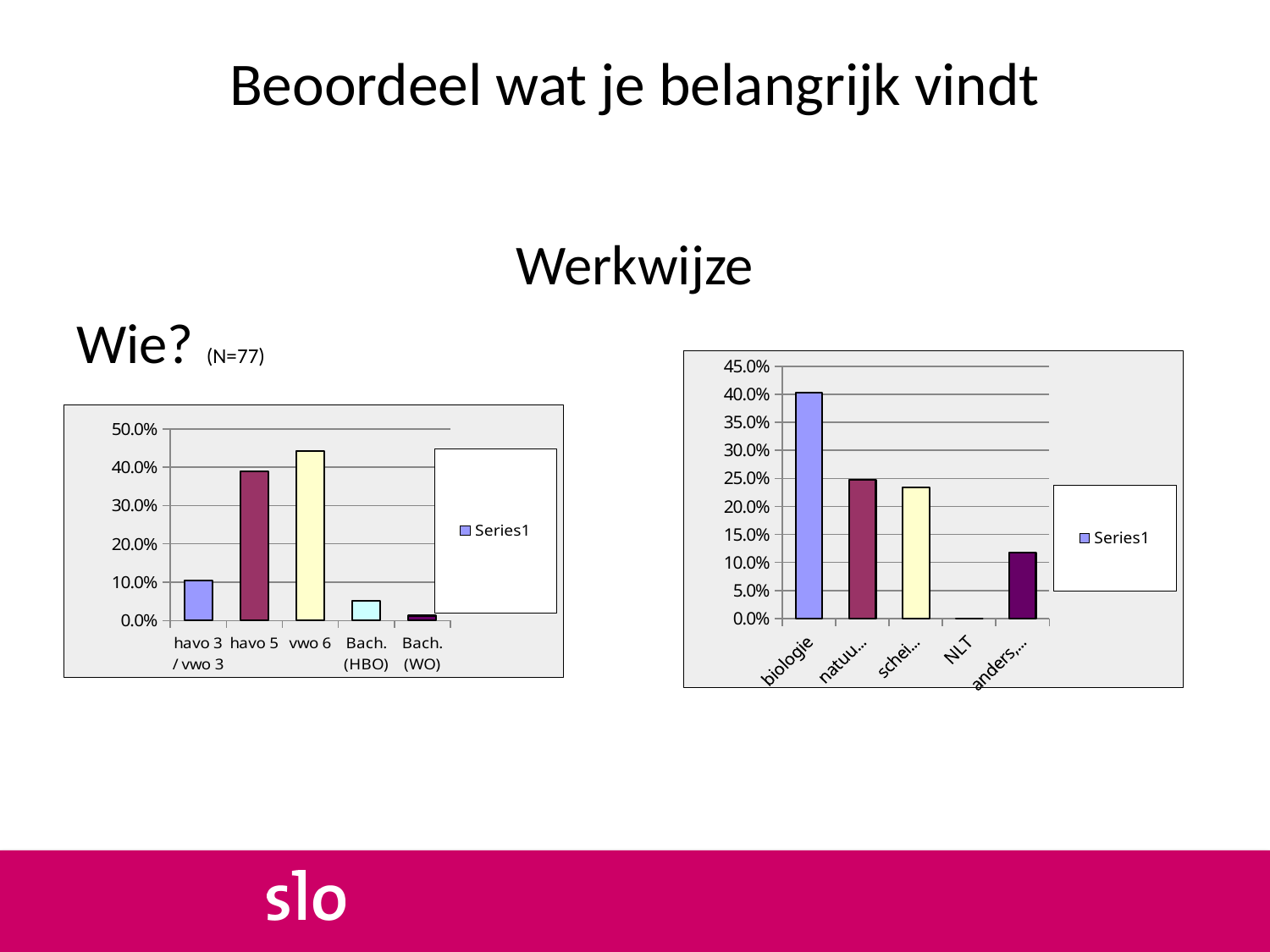
In the left chart (under 'Wie?'), is the value for havo 5 greater or less than 30.0%? greater In the left chart (under 'Wie?'), how many categories are shown on the x axis? 5 What kind of chart is the right chart (under 'Werkwijze')? bar chart In the right chart (under 'Werkwijze'), is the value for biologie greater or less than 35.0%? greater In the right chart (under 'Werkwijze'), which category has the highest value? biologie In the left chart (under 'Wie?'), which is larger: the value for havo 3 / vwo 3 or the value for Bach. (HBO)? havo 3 / vwo 3 What kind of chart is the left chart (under 'Wie?')? bar chart In the left chart (under 'Wie?'), which category has the lowest value? Bach. (WO) In the right chart (under 'Werkwijze'), which category has the lowest value? NLT In the left chart (under 'Wie?'), which category has the highest value? vwo 6 In the right chart (under 'Werkwijze'), how many categories are shown on the x axis? 5 In the left chart (under 'Wie?'), how many series does the legend list? 1